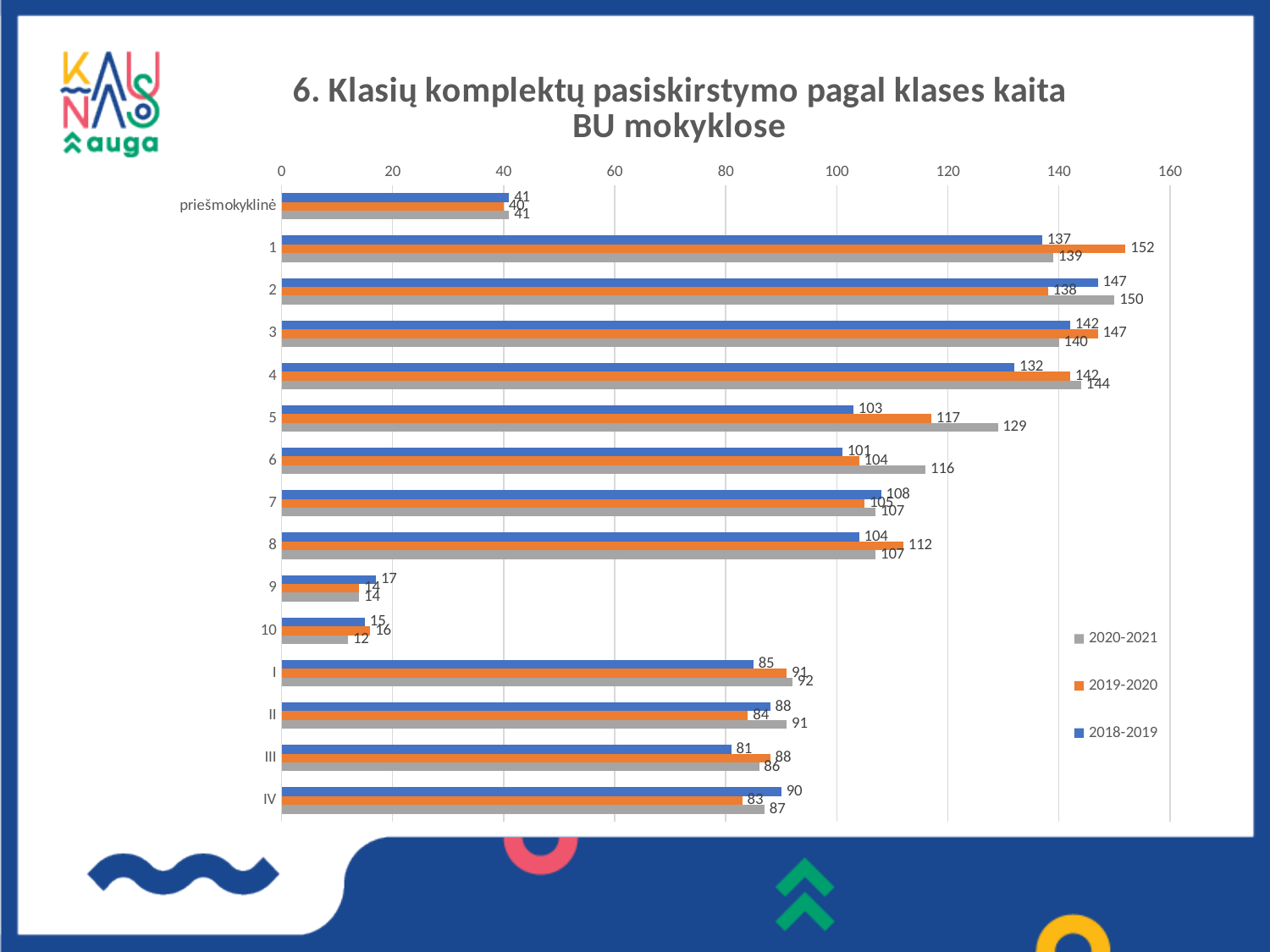
For class 4, which series has the larger value: 2018-2019 or 2020-2021? 2020-2021 What is the value for class 5 in the 2020-2021 series? 129 How many series does the legend list? 3 What type of chart is shown on the slide? bar chart What is the value for class 1 in the 2019-2020 series? 152 What is the value for class IV in the 2018-2019 series? 90 Is the value for class 6 in the 2020-2021 series greater or less than 100? greater Which category has the lowest value in the 2020-2021 series? 10 How many categories are shown on the vertical axis? 15 Which category has the highest value in the 2020-2021 series? 2 What is the title of the chart? 6. Klasių komplektų pasiskirstymo pagal klases kaita BU mokyklose What is the difference between the 2020-2021 and 2018-2019 values for class 5? 26